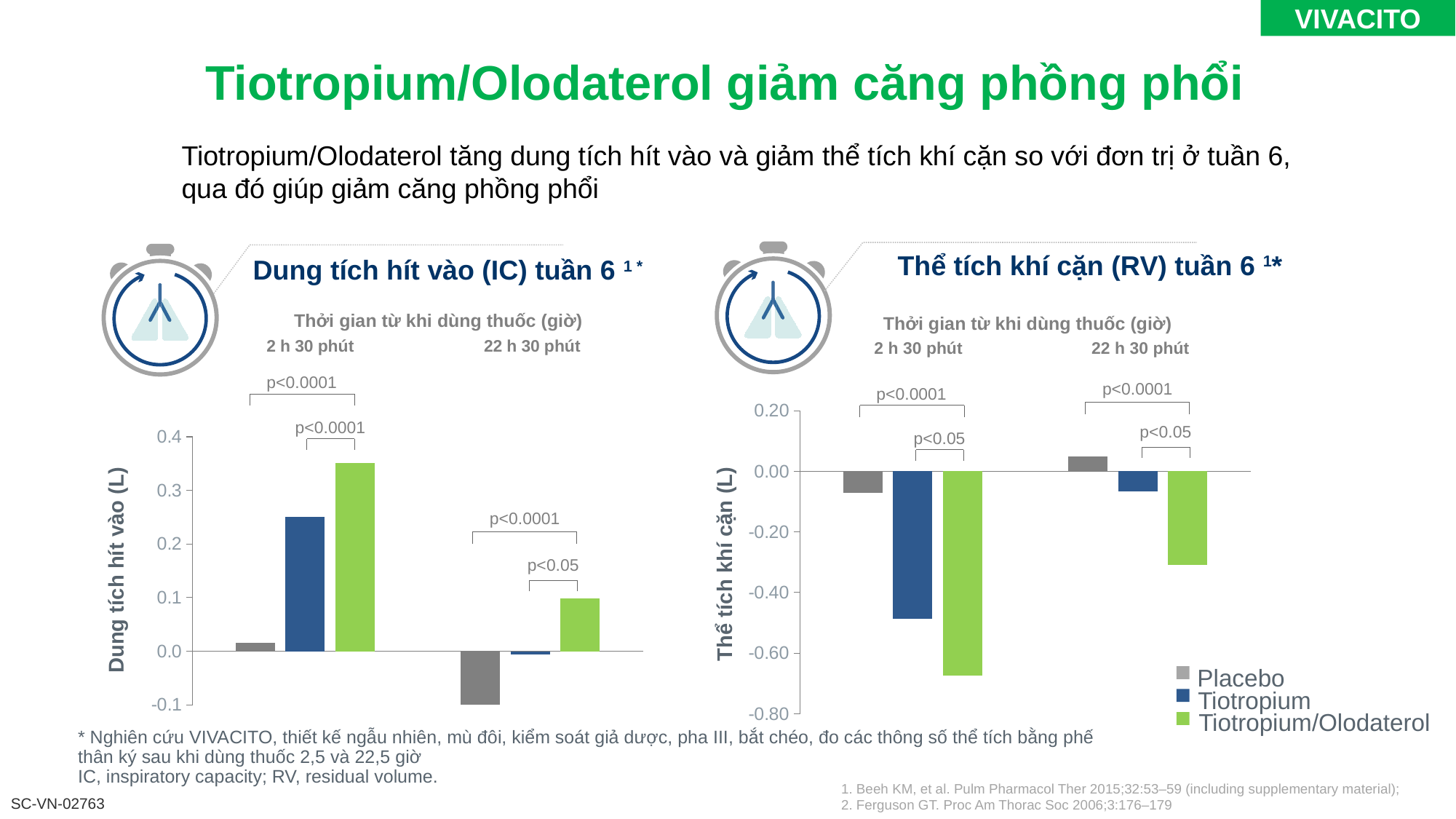
What is the y-axis label of the 'Thể tích khí cặn (RV) tuần 6' chart? Thể tích khí cặn (L) In the 'Dung tích hít vào (IC) tuần 6' chart, is the Tiotropium/Olodaterol value at 2 h 30 phút greater or less than 0.3? greater In the 'Dung tích hít vào (IC) tuần 6' chart, which series has the lowest value at 22 h 30 phút? Placebo In the 'Dung tích hít vào (IC) tuần 6' chart, how many time-point categories are shown on the x axis? 2 What kind of chart is the 'Dung tích hít vào (IC) tuần 6' chart? bar chart In the 'Dung tích hít vào (IC) tuần 6' chart, which series has the highest value at 2 h 30 phút? Tiotropium/Olodaterol In the 'Thể tích khí cặn (RV) tuần 6' chart, which is larger at 22 h 30 phút, the Placebo value or the Tiotropium/Olodaterol value? Placebo How many series does the legend list for the charts on the slide? 3 In the 'Thể tích khí cặn (RV) tuần 6' chart, is the Tiotropium value at 2 h 30 phút greater or less than -0.40? less In the 'Thể tích khí cặn (RV) tuần 6' chart, which series has the lowest value at 2 h 30 phút? Tiotropium/Olodaterol In the 'Dung tích hít vào (IC) tuần 6' chart, is the Tiotropium value at 2 h 30 phút greater or less than 0.3? less